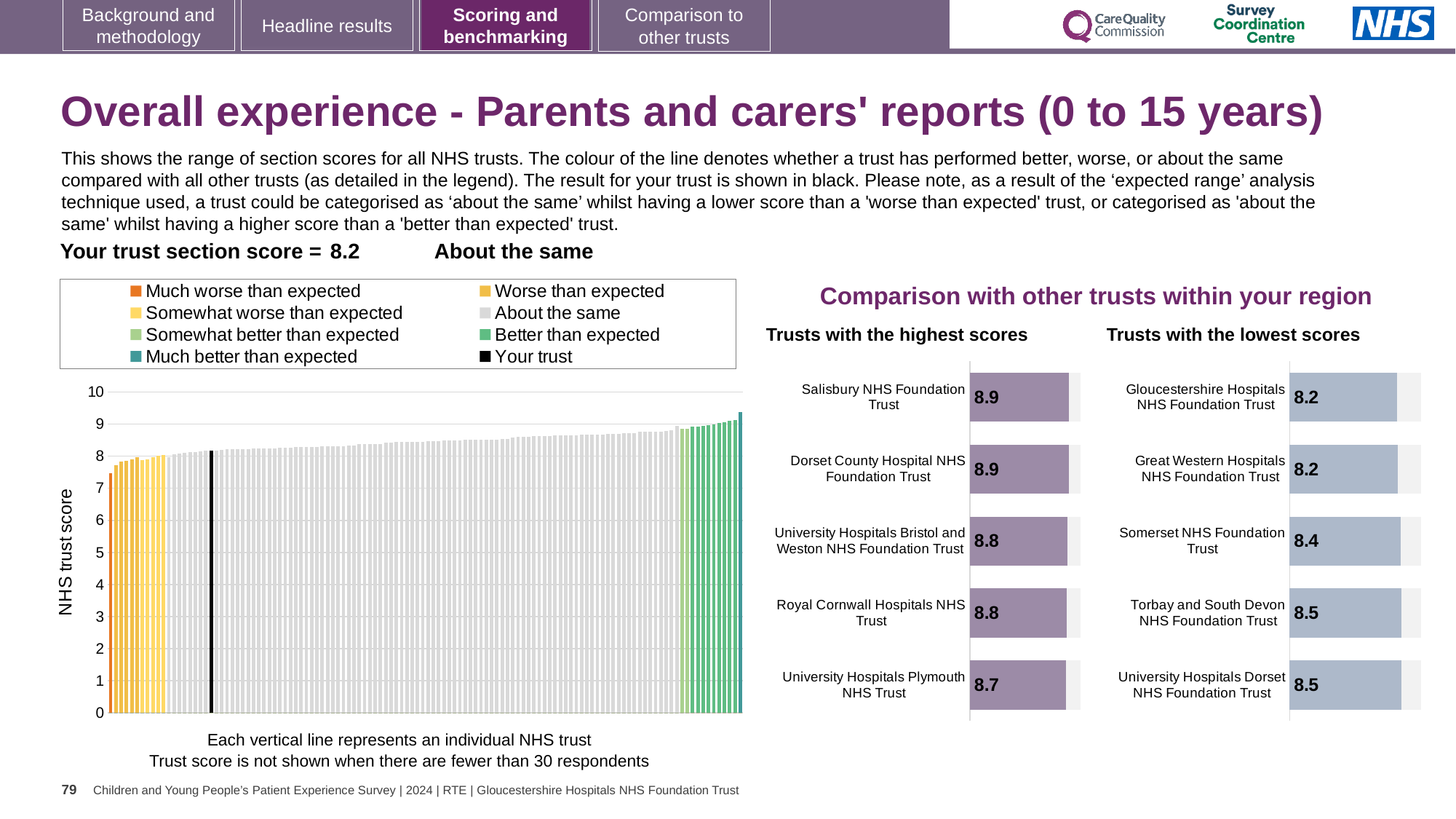
In the 'Trusts with the highest scores' chart, what is the score for University Hospitals Plymouth NHS Trust? 8.7 In the 'Trusts with the lowest scores' chart, what is the score for Gloucestershire Hospitals NHS Foundation Trust? 8.2 In the large chart on the left, is the value of the leftmost (orange) bar greater or less than 8? less In the 'Trusts with the lowest scores' chart, what is the score for Somerset NHS Foundation Trust? 8.4 In the 'Trusts with the lowest scores' chart, what is the difference between the scores of University Hospitals Dorset NHS Foundation Trust and Gloucestershire Hospitals NHS Foundation Trust? 0.3 In the 'Trusts with the highest scores' chart, what is the difference between the scores of Salisbury NHS Foundation Trust and University Hospitals Plymouth NHS Trust? 0.2 What kind of chart is the large chart on the left showing NHS trust scores? Bar chart How many entries does the legend of the large chart on the left list? 8 In the 'Trusts with the highest scores' chart, what is the score for Salisbury NHS Foundation Trust? 8.9 How many trusts are listed in the 'Trusts with the highest scores' chart? 5 In the large chart on the left, do the trust scores rise or fall from left to right along the x axis? Rise In the 'Trusts with the lowest scores' chart, which has the larger score: Torbay and South Devon NHS Foundation Trust or Great Western Hospitals NHS Foundation Trust? Torbay and South Devon NHS Foundation Trust